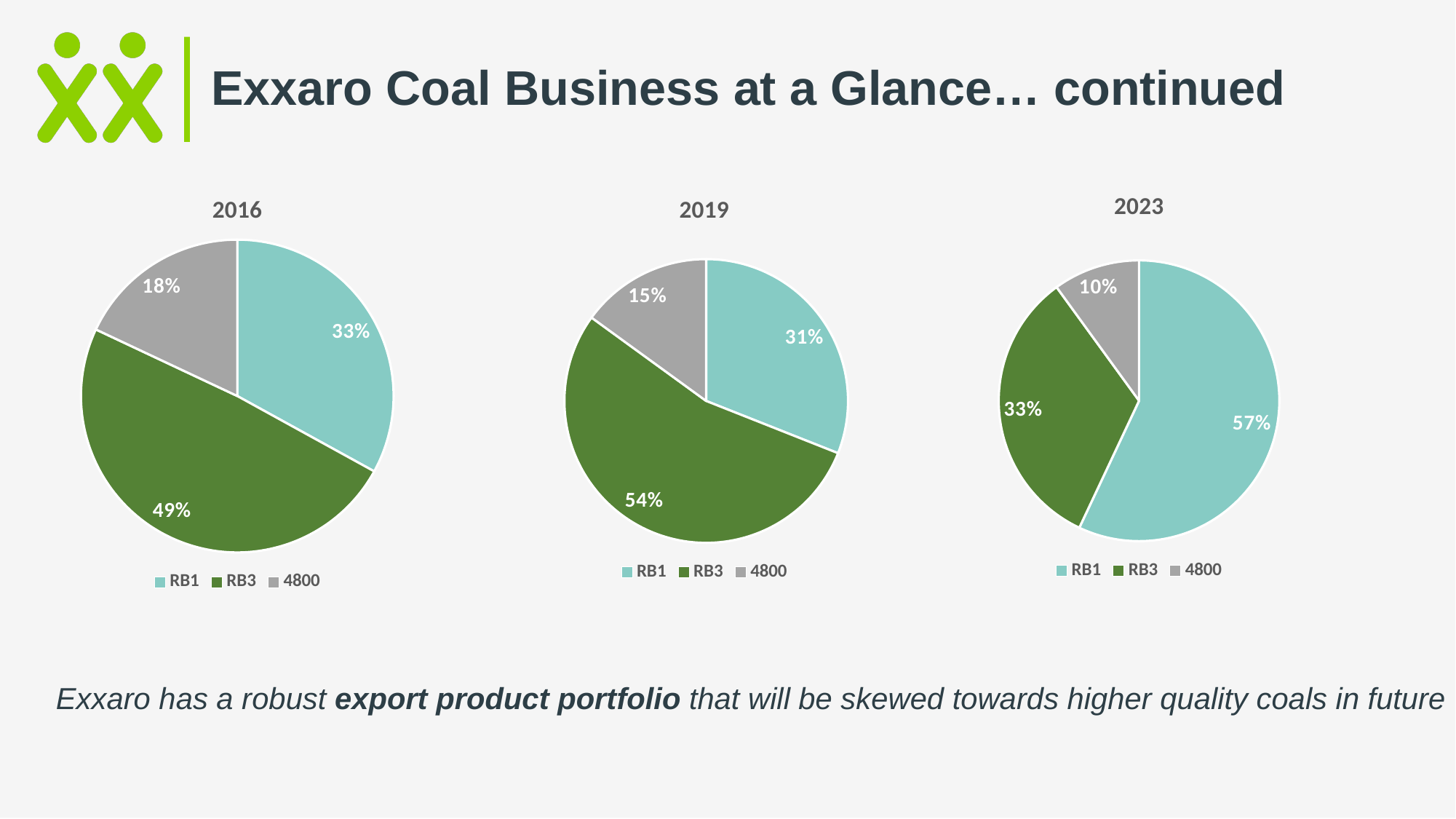
What kind of chart is used for the 2016 data? Pie chart In the 2019 pie chart, what share does 4800 have? 15% In the 2023 pie chart, what share does RB1 have? 57% Which colour represents RB1 in the legend of the 2023 pie chart? Teal (light blue-green) How many pie charts are shown on the slide? 3 In the 2016 pie chart, what share does RB3 have? 49% In the 2019 pie chart, what is the difference between the RB3 share and the RB1 share? 23% In the 2023 pie chart, which category has the smallest share? 4800 In the 2023 pie chart, which is larger, the share for RB1 or the share for RB3? RB1 How many slices does the 2019 pie chart have? 3 In the 2016 pie chart, which category has the largest share? RB3 In the 2016 pie chart, what share does 4800 have? 18%